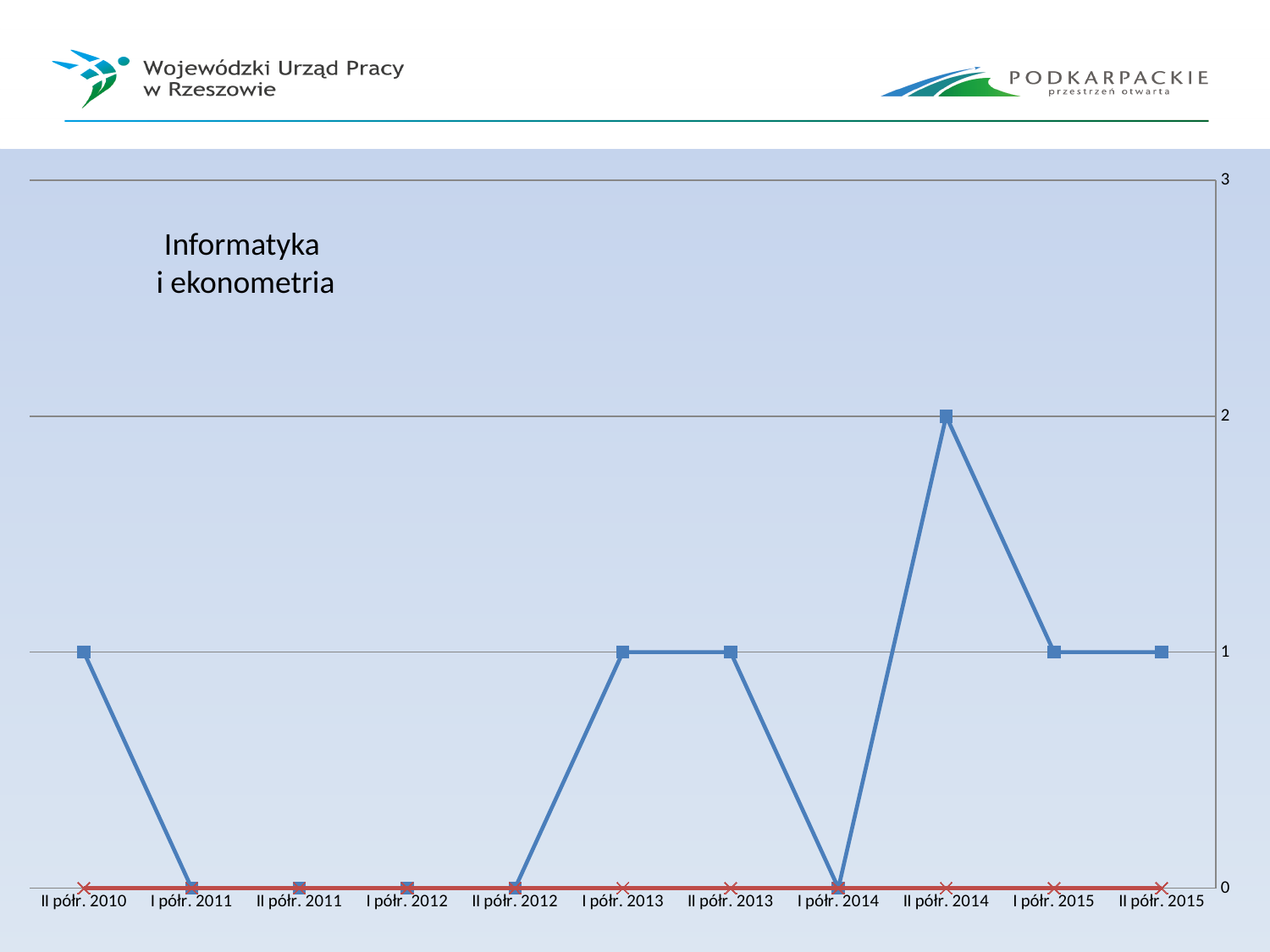
What is the title of the chart? Informatyka i ekonometria In which period does the blue line reach its highest value? II półr. 2014 What is the value of the blue line for II półr. 2010? 1 What kind of chart is shown on the slide? line chart What is the highest value shown on the vertical axis? 3 What is the value of the blue line for I półr. 2012? 0 What is the value of the blue line for II półr. 2014? 2 What is the value of the red line for I półr. 2014? 0 How many categories are shown on the x axis? 11 Which is larger for the blue line: the value for I półr. 2013 or the value for I półr. 2014? I półr. 2013 What is the difference between the blue line's values for II półr. 2014 and I półr. 2015? 1 Does the blue line rise or fall between I półr. 2014 and II półr. 2014? rise